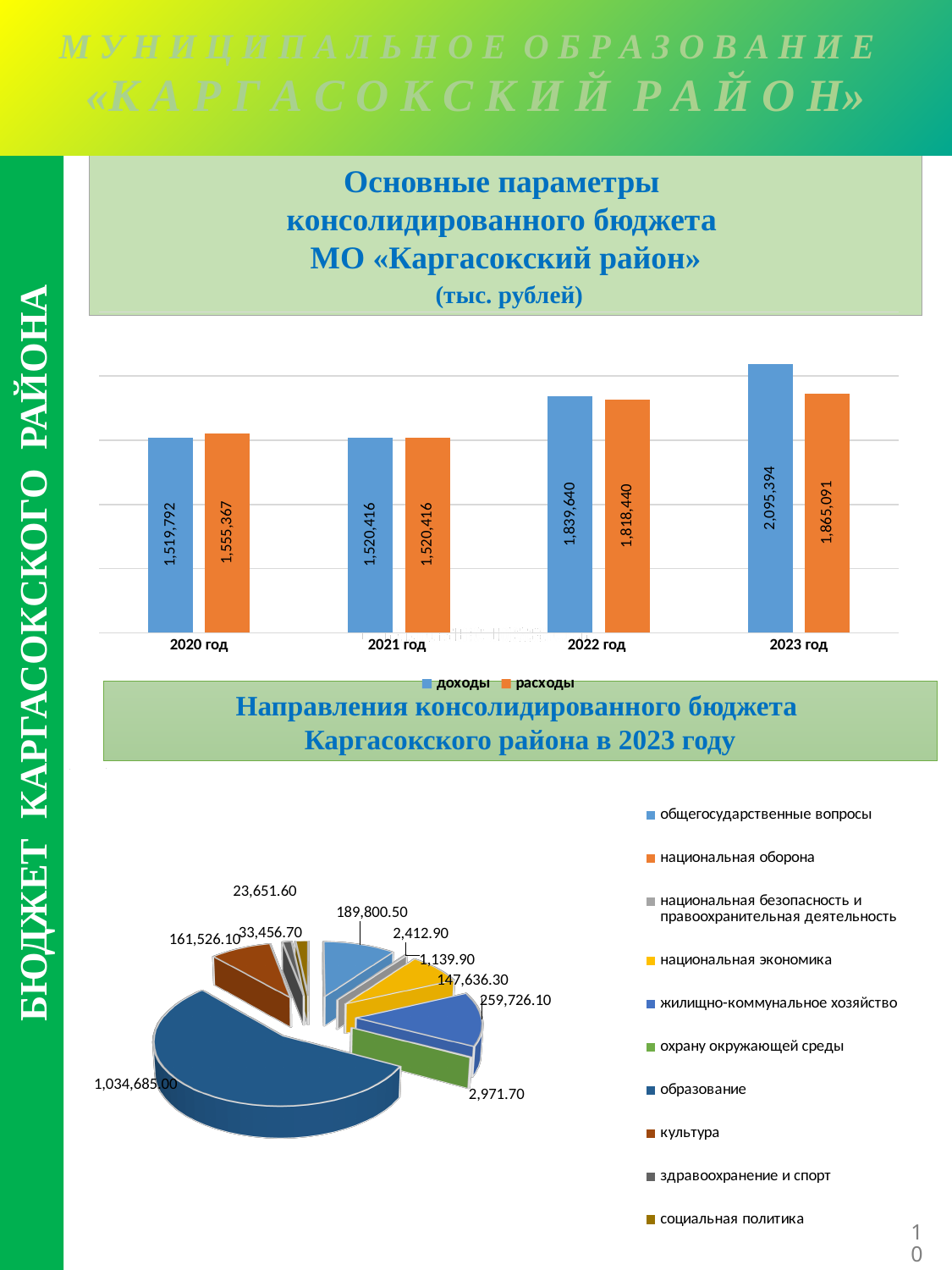
In the top bar chart, which is larger for 2020 год: доходы or расходы? расходы In the bottom pie chart, what is the value labelled for образование? 1,034,685.00 In the bottom pie chart, which category has the largest slice? образование In the top bar chart, what is the value of доходы for 2023 год? 2,095,394 In the top bar chart, what is the difference between доходы and расходы in 2022 год? 21,200 What kind of chart is the bottom chart titled «Направления консолидированного бюджета Каргасокского района в 2023 году»? pie chart How many series does the legend of the top bar chart list? 2 How many years are shown on the x axis of the top bar chart? 4 Do the доходы values in the top chart rise or fall from 2020 год to 2023 год? rise In the top bar chart, which year has the highest доходы? 2023 год In the top bar chart, what is the value of расходы for 2020 год? 1,555,367 In the top bar chart, what is the difference between доходы and расходы in 2023 год? 230,303